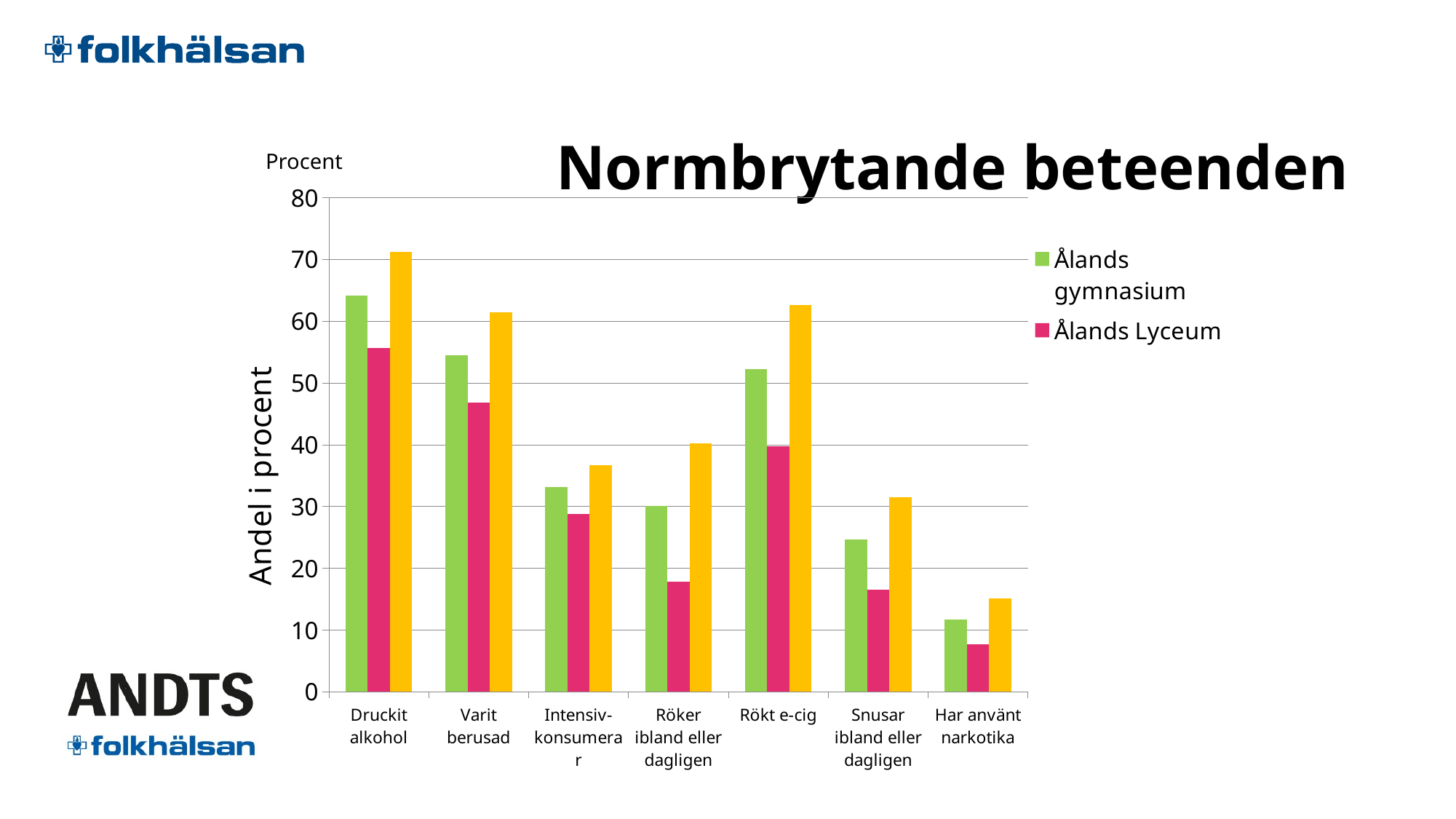
Is the value for Ålands Lyceum in the Har använt narkotika category greater or less than 10? less What is the label of the vertical axis? Andel i procent How many series does the chart's legend list? 2 In the Rökt e-cig category, which is larger: the value for Ålands gymnasium or for Ålands Lyceum? Ålands gymnasium How many categories are shown on the x axis of the chart? 7 Is the value for Ålands gymnasium in the Druckit alkohol category greater or less than 60? greater Which category has the lowest value for Ålands Lyceum? Har använt narkotika Is the value for Ålands Lyceum in the Röker ibland eller dagligen category greater or less than 20? less What kind of chart is shown on the slide? bar chart What is the title of the chart? Normbrytande beteenden Which category has the highest value for Ålands gymnasium? Druckit alkohol